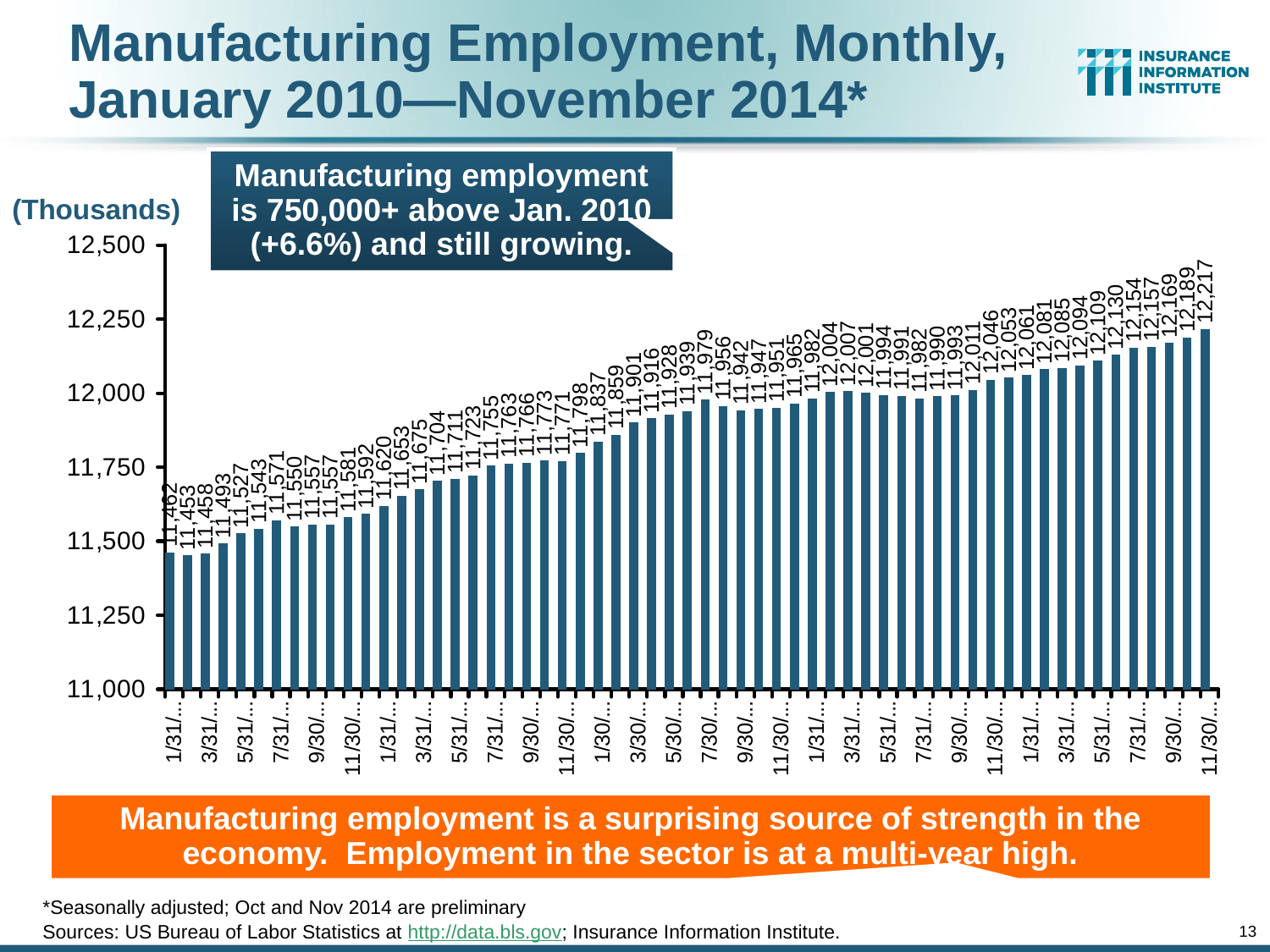
Which is larger: the value of the first bar on the left or the value of the last bar on the right? the last bar on the right What is the value of the first bar on the left (1/31/...) in the manufacturing employment chart? 11,462 What type of chart is shown on the slide? bar chart In what units are the values on the chart's y axis expressed? Thousands What is the difference between the last bar (12,217) and the first bar (11,462) in the chart? 755 What is the value of the last bar on the right (11/30/...) in the manufacturing employment chart? 12,217 What is the highest value shown in the manufacturing employment chart? 12,217 How many bars are plotted in the manufacturing employment chart? 59 Overall, do the values in the chart rise or fall from left to right along the x axis? rise What is the lowest value shown in the manufacturing employment chart? 11,453 Is the value of the first bar on the left greater or less than 11,500? less Is the value of the last bar on the right greater or less than 12,000? greater